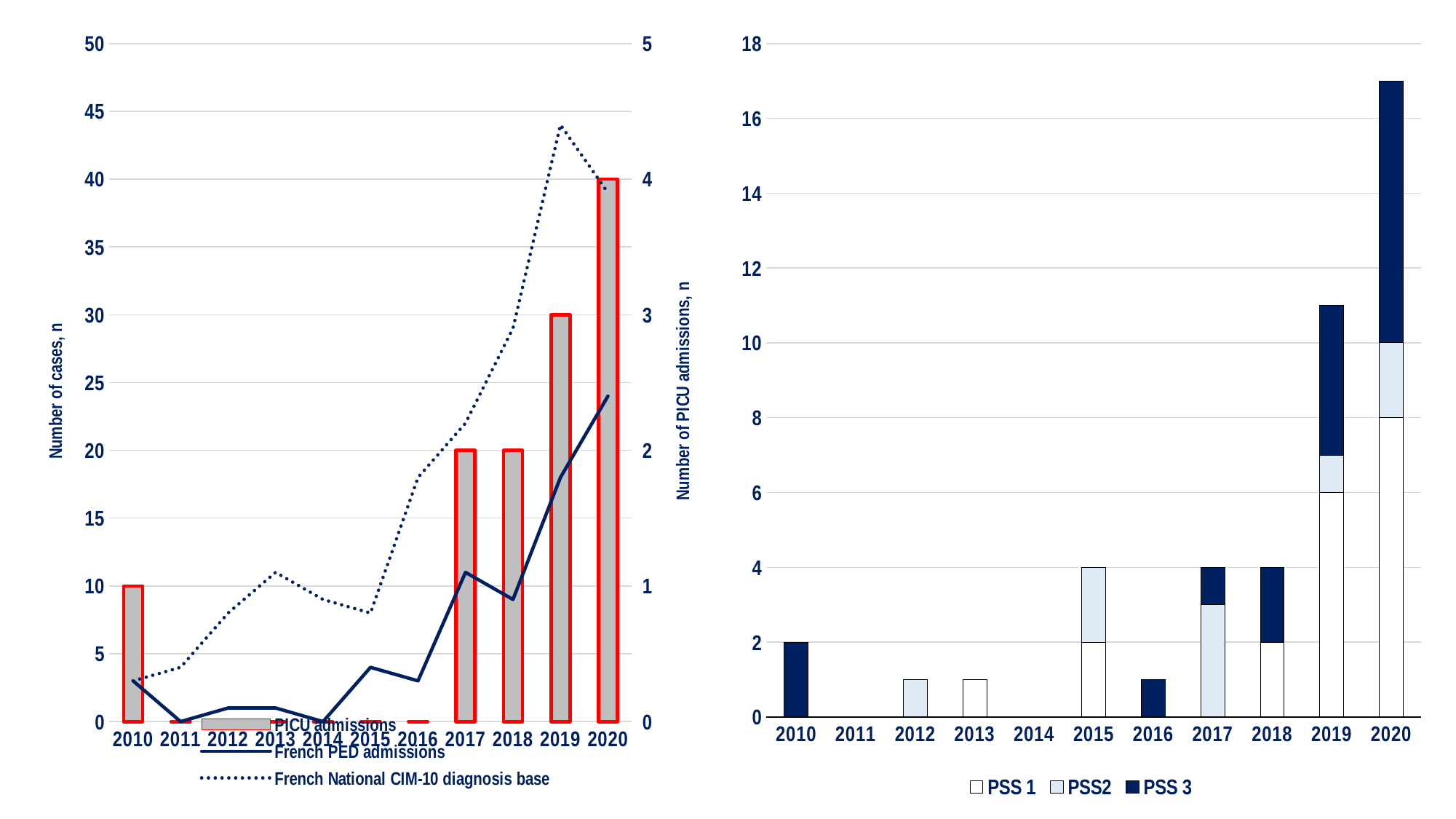
On the right chart, what is the PSS 1 value for 2020? 8 On the left chart, what is the number of PICU admissions in 2019? 3 On the left chart, which year has the highest number of PICU admissions? 2020 On the right chart, what kind of chart is it? Stacked bar chart On the right chart, how many series does the legend list? 3 On the left chart, what is the number of PICU admissions in 2020? 4 On the left chart, is the French National CIM-10 diagnosis base value for 2019 greater or less than 40? greater On the left chart, how many series does the legend list? 3 On the right chart, is the total for 2020 greater or less than 16? greater On the right chart, how many years are shown on the x axis? 11 On the right chart, what is the total height of the stacked bar for 2010? 2 On the left chart, what kind of chart is it? A combined bar and line chart